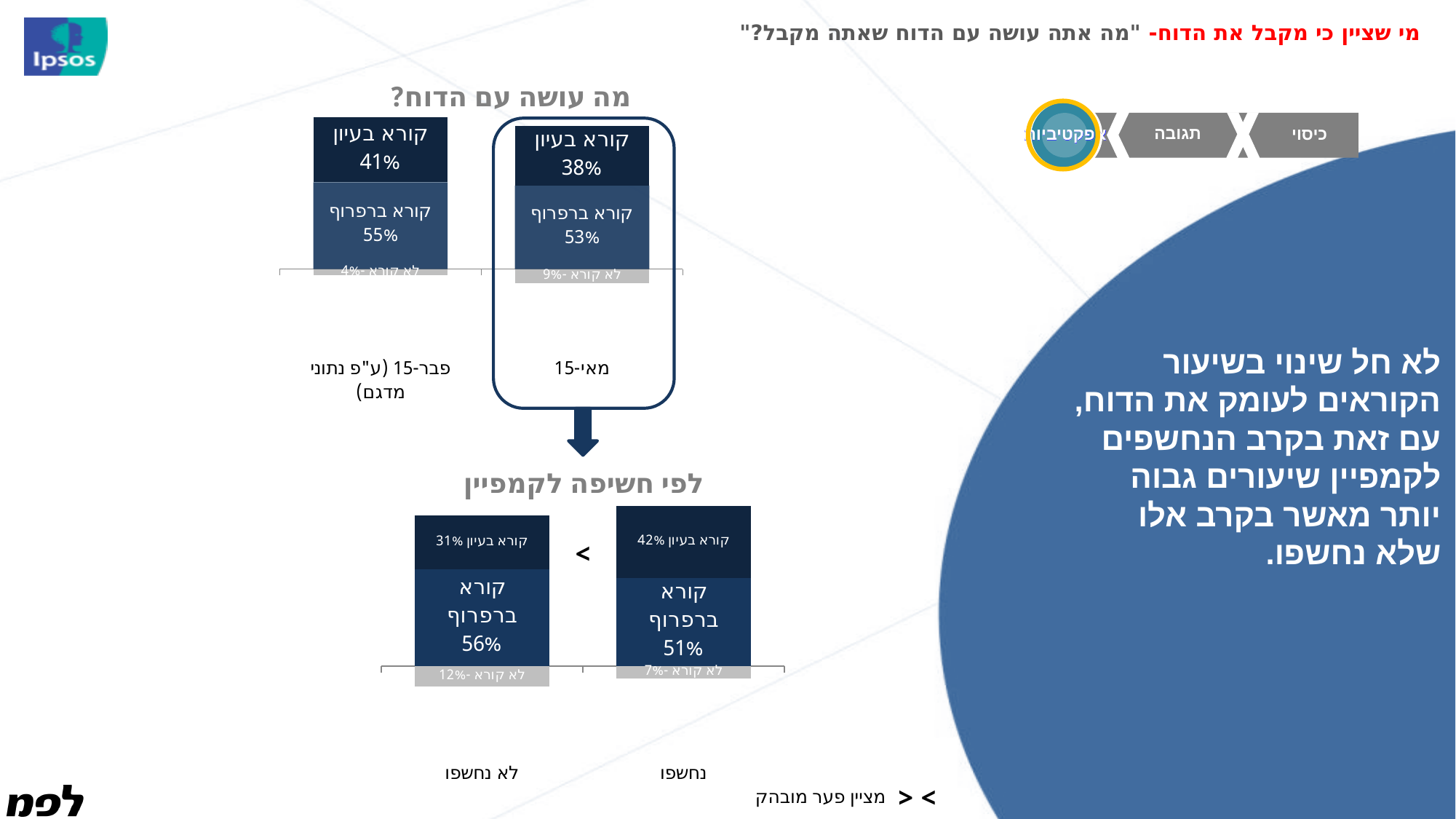
In the bottom chart titled "לפי חשיפה לקמפיין", what is the value for "לא קורא" among "נחשפו"? 7% In the bottom chart titled "לפי חשיפה לקמפיין", which group has the larger "לא קורא" value, "נחשפו" or "לא נחשפו"? לא נחשפו In the top chart titled "מה עושה עם הדוח?", what is the difference between the "קורא בעיון" values for "פבר-15" and "מאי-15"? 3% In the top chart titled "מה עושה עם הדוח?", which period has the larger "לא קורא" value, "פבר-15" or "מאי-15"? מאי-15 In the bottom chart titled "לפי חשיפה לקמפיין", what is the difference between the "קורא בעיון" values for "נחשפו" and "לא נחשפו"? 11% In the bottom chart titled "לפי חשיפה לקמפיין", what is the value for "קורא ברפרוף" among "לא נחשפו"? 56% In the top chart titled "מה עושה עם הדוח?", what is the value for "קורא ברפרוף" in "פבר-15"? 55% In the bottom chart titled "לפי חשיפה לקמפיין", what is the value for "קורא בעיון" among "נחשפו"? 42% What kind of chart is the top chart titled "מה עושה עם הדוח?"? Stacked bar chart How many categories (bars) are shown in the bottom chart titled "לפי חשיפה לקמפיין"? 2 In the top chart titled "מה עושה עם הדוח?", what is the value for "קורא בעיון" in "מאי-15"? 38% In the top chart titled "מה עושה עם הדוח?", what is the value for "לא קורא" in "מאי-15"? 9%